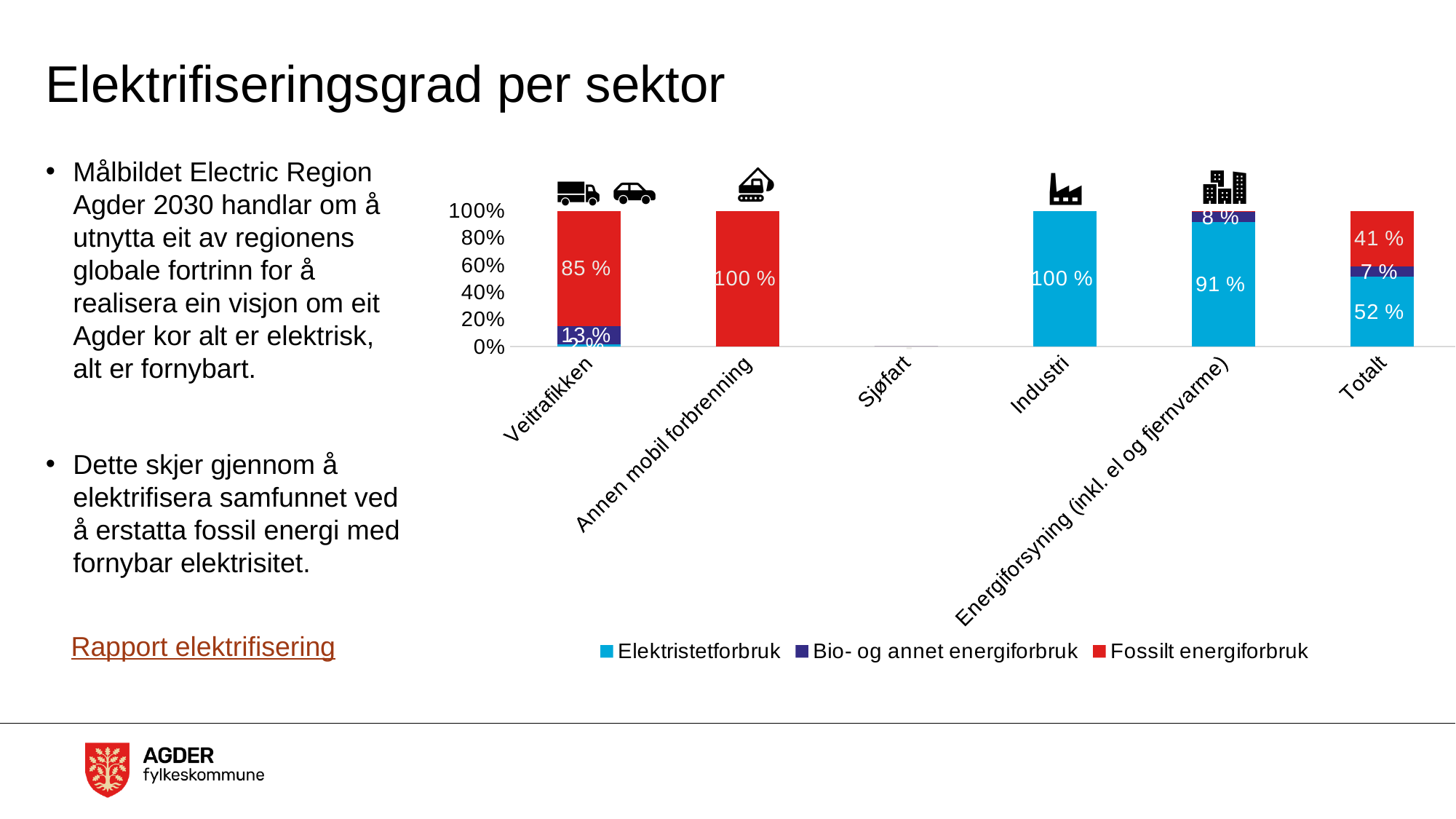
Which category has no bar plotted at all? Sjøfart What is the Fossilt energiforbruk value for Annen mobil forbrenning? 100 % How many series does the legend list? 3 What is the Elektristetforbruk value for Energiforsyning (inkl. el og fjernvarme)? 91 % What is the Fossilt energiforbruk value for Totalt? 41 % How many categories are shown on the x axis? 6 What is the difference between the Elektristetforbruk value and the Fossilt energiforbruk value for Totalt? 11 % What is the Fossilt energiforbruk value for Veitrafikken? 85 % Which is larger for Totalt: Elektristetforbruk or Bio- og annet energiforbruk? Elektristetforbruk What is the Elektristetforbruk value for Industri? 100 % What kind of chart is shown on the slide? stacked bar chart What is the Bio- og annet energiforbruk value for Veitrafikken? 13 %